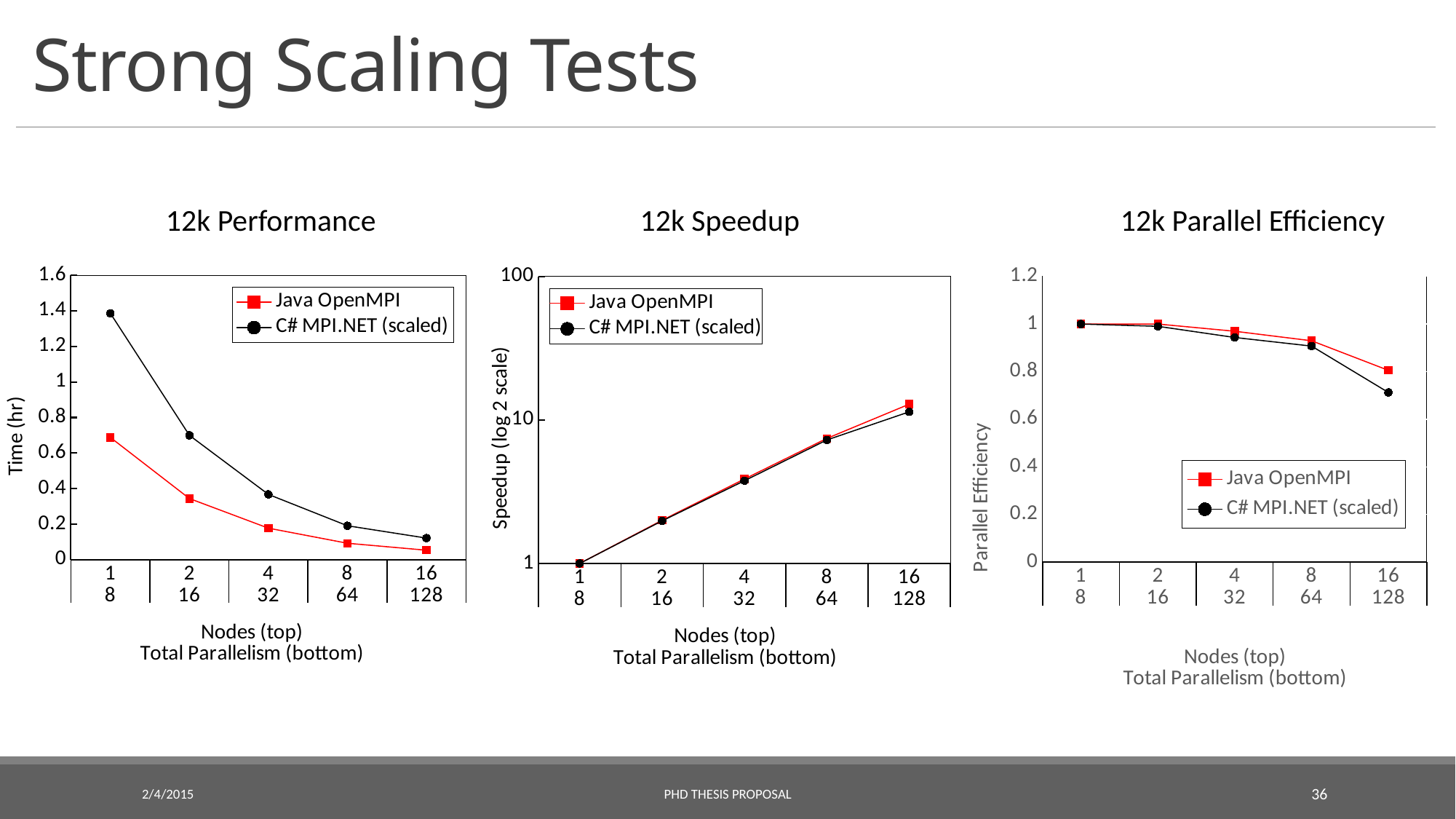
In the 12k Performance chart, which series has the higher time at 1 node, Java OpenMPI or C# MPI.NET (scaled)? C# MPI.NET (scaled) In the 12k Performance chart, is the time for C# MPI.NET (scaled) at 1 node greater or less than 1.2 hr? greater In the 12k Performance chart, is the time for Java OpenMPI at 1 node greater or less than 0.8 hr? less In the 12k Parallel Efficiency chart, does the efficiency for C# MPI.NET (scaled) rise or fall as the number of nodes increases? fall What is the y-axis label of the 12k Speedup chart? Speedup (log 2 scale) In the 12k Parallel Efficiency chart, is the efficiency for C# MPI.NET (scaled) at 16 nodes greater or less than 0.8? less In the 12k Speedup chart, does the speedup for Java OpenMPI rise or fall as the number of nodes increases? rise What kind of chart is the 12k Performance chart? line chart How many series does the legend of the 12k Speedup chart list? 2 How many node counts are plotted along the x axis of the 12k Parallel Efficiency chart? 5 In the 12k Performance chart, does the time for C# MPI.NET (scaled) rise or fall as the number of nodes increases? fall In the 12k Parallel Efficiency chart, which series has the higher efficiency at 16 nodes, Java OpenMPI or C# MPI.NET (scaled)? Java OpenMPI